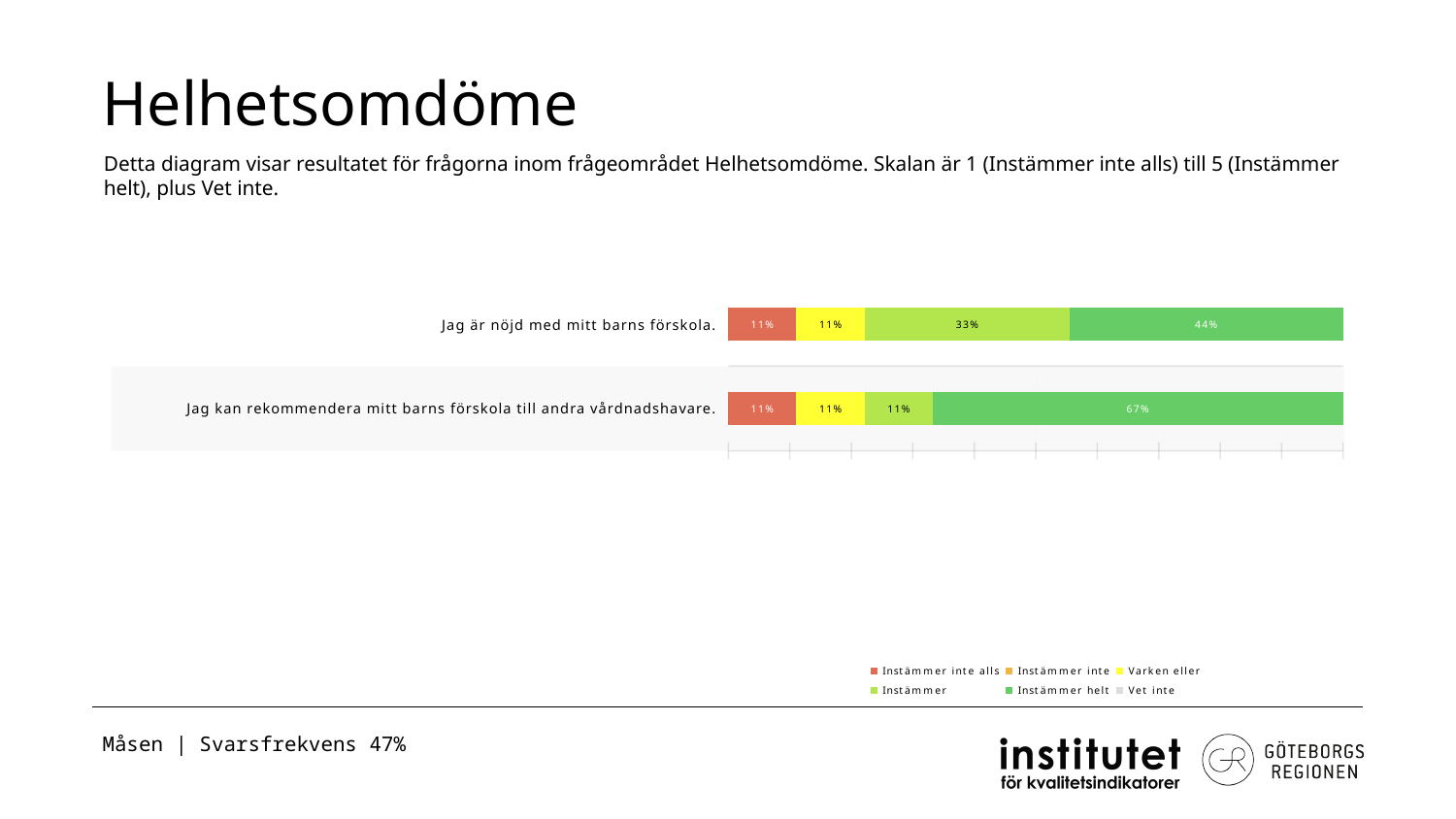
What is the 'Instämmer helt' value for 'Jag är nöjd med mitt barns förskola.'? 44% What is the difference in 'Instämmer helt' between 'Jag kan rekommendera mitt barns förskola till andra vårdnadshavare.' and 'Jag är nöjd med mitt barns förskola.'? 23% Which statement has the larger 'Instämmer helt' share? Jag kan rekommendera mitt barns förskola till andra vårdnadshavare. What is the 'Instämmer inte alls' value for 'Jag kan rekommendera mitt barns förskola till andra vårdnadshavare.'? 11% What is the 'Instämmer' value for 'Jag är nöjd med mitt barns förskola.'? 33% What is the total of the labelled segments in the bar for 'Jag kan rekommendera mitt barns förskola till andra vårdnadshavare.'? 100% How many statements (categories) are plotted in the chart? 2 What is the 'Instämmer helt' value for 'Jag kan rekommendera mitt barns förskola till andra vårdnadshavare.'? 67% How many series does the legend list? 6 What is the difference in 'Instämmer' between 'Jag är nöjd med mitt barns förskola.' and 'Jag kan rekommendera mitt barns förskola till andra vårdnadshavare.'? 22% What kind of chart is shown on the slide? Stacked bar chart What colour represents 'Instämmer inte alls' in the legend? Red